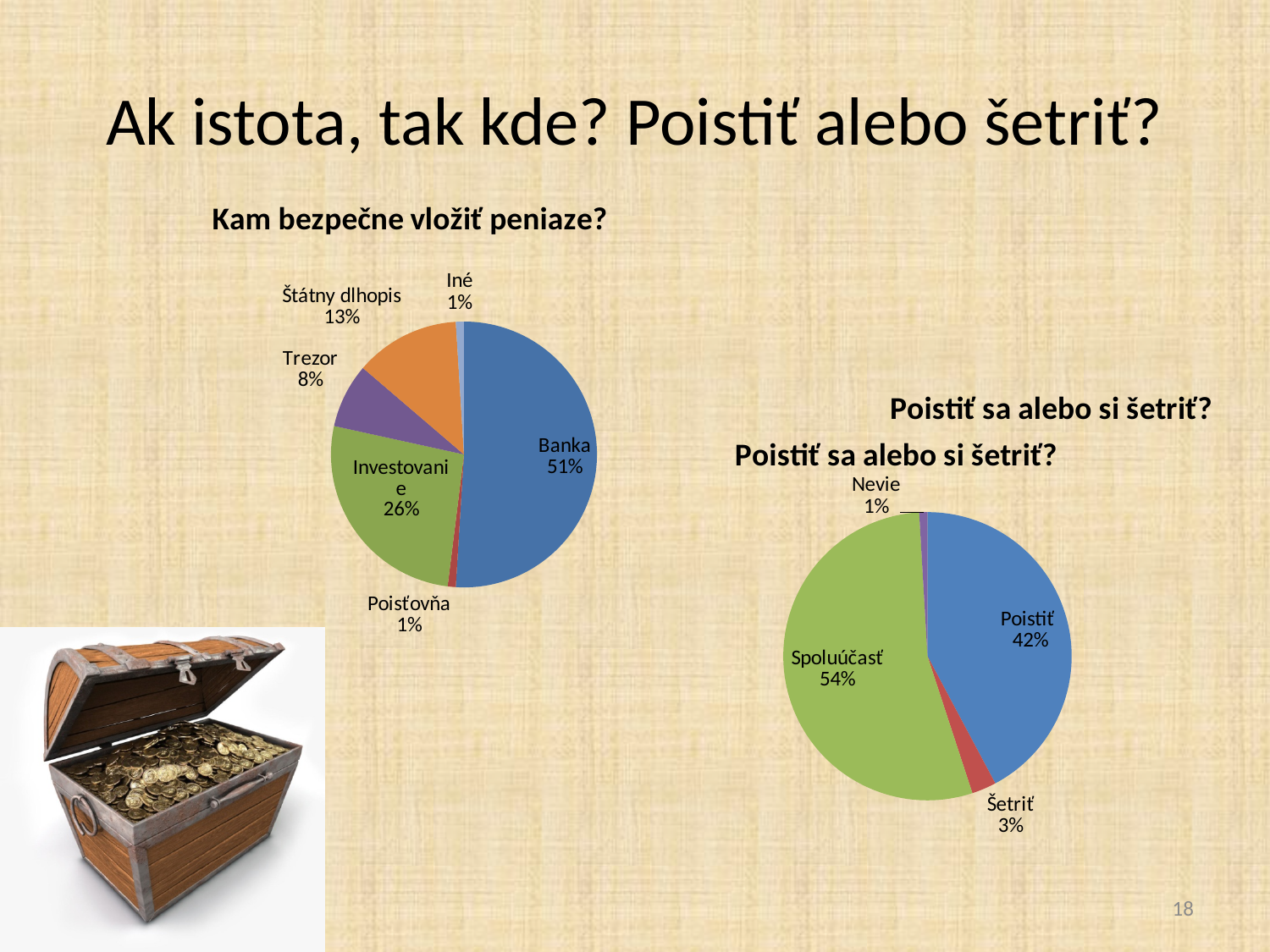
In the chart 'Kam bezpečne vložiť peniaze?', what share does Banka have? 51% In the chart 'Poistiť sa alebo si šetriť?', what share does Poistiť have? 42% In the chart 'Kam bezpečne vložiť peniaze?', which is larger, Trezor or Štátny dlhopis? Štátny dlhopis In the chart 'Kam bezpečne vložiť peniaze?', what share does Štátny dlhopis have? 13% In the chart 'Poistiť sa alebo si šetriť?', what share does Spoluúčasť have? 54% In the chart 'Poistiť sa alebo si šetriť?', which category has the smallest share? Nevie In the chart 'Poistiť sa alebo si šetriť?', how many categories are shown? 4 In the chart 'Kam bezpečne vložiť peniaze?', what is the difference between the shares of Banka and Investovanie? 25% In the chart 'Kam bezpečne vložiť peniaze?', which category has the largest share? Banka In the chart 'Kam bezpečne vložiť peniaze?', what share does Investovanie have? 26% What kind of chart is 'Poistiť sa alebo si šetriť?'? Pie chart In the chart 'Kam bezpečne vložiť peniaze?', how many categories are shown? 6